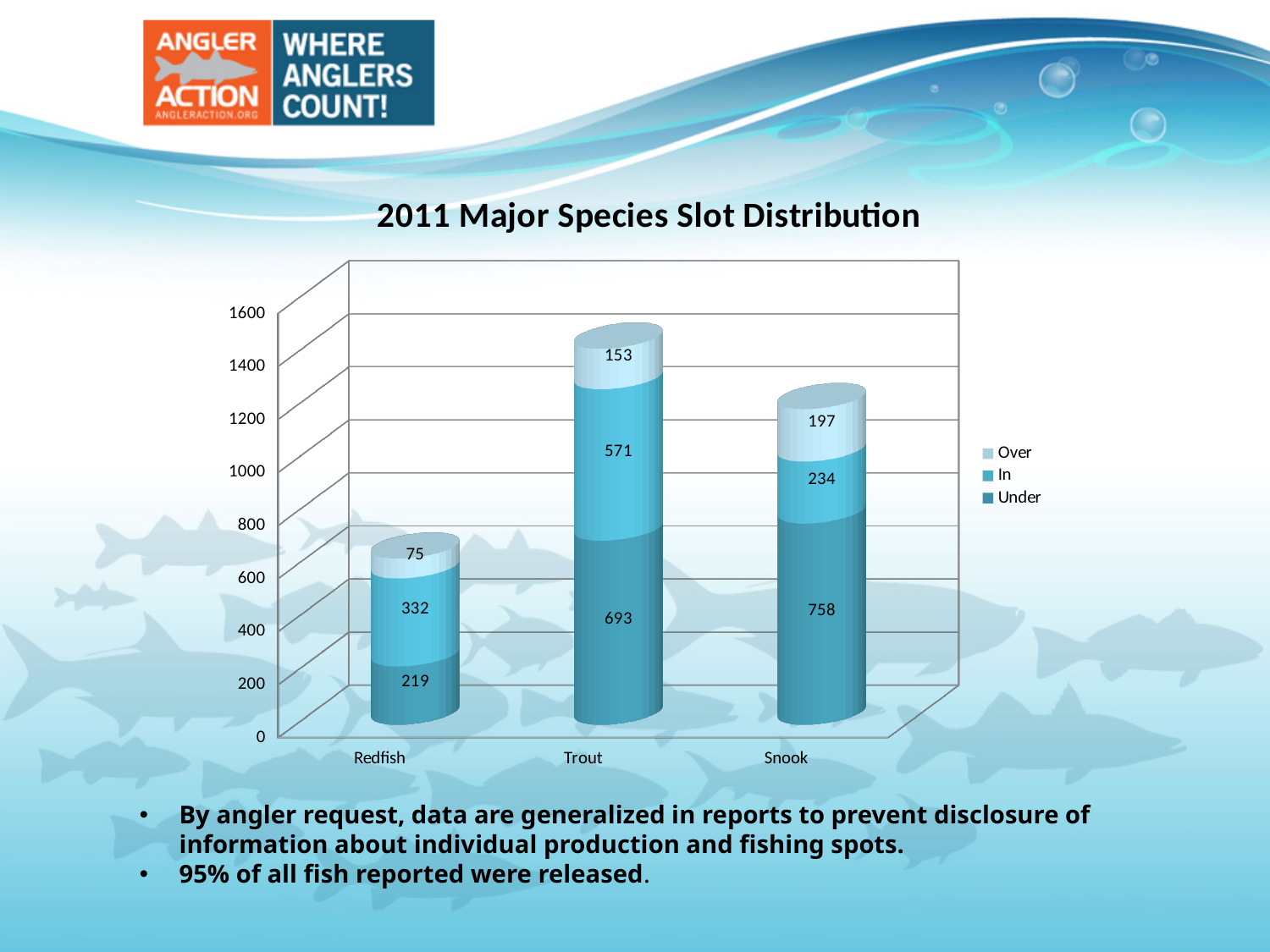
What is the 'In' value for Redfish? 332 What is the difference between the 'In' values for Trout and Snook? 337 How many species categories are shown on the x axis? 3 Which species has the lowest 'In' value? Snook Is the total stacked bar for Trout greater or less than 1200? greater What is the 'Over' value for Snook? 197 Which species has the highest 'Under' value? Snook What is the 'Under' value for Trout? 693 What kind of chart is shown on the slide? Stacked bar chart What is the title of the chart? 2011 Major Species Slot Distribution How many series does the legend list? 3 What is the total of the stacked bar for Redfish? 626